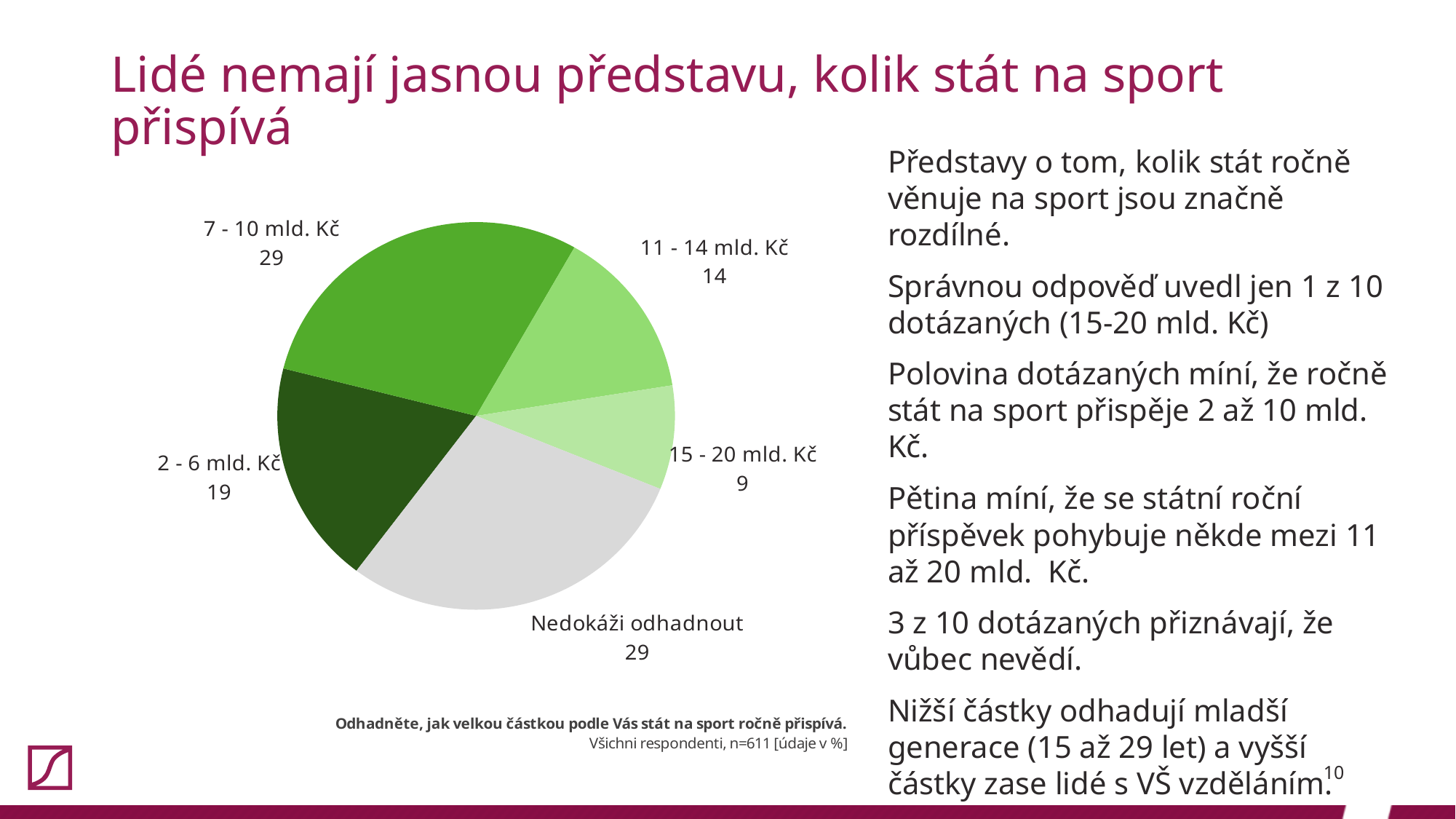
Which category has the smallest slice in the pie chart? 15 - 20 mld. Kč What is the combined value of the "7 - 10 mld. Kč" and "2 - 6 mld. Kč" slices? 48 What is the value for the "Nedokáži odhadnout" slice? 29 How many slices does the pie chart have? 5 Which is larger: the value for "2 - 6 mld. Kč" or the value for "11 - 14 mld. Kč"? 2 - 6 mld. Kč What kind of chart is shown on the slide? pie chart What is the value for the "11 - 14 mld. Kč" slice? 14 What colour is the "Nedokáži odhadnout" slice? grey What is the difference between the values for "7 - 10 mld. Kč" and "15 - 20 mld. Kč"? 20 What is the value for the "2 - 6 mld. Kč" slice? 19 What is the difference between the values for "2 - 6 mld. Kč" and "11 - 14 mld. Kč"? 5 What is the value for the "15 - 20 mld. Kč" slice? 9